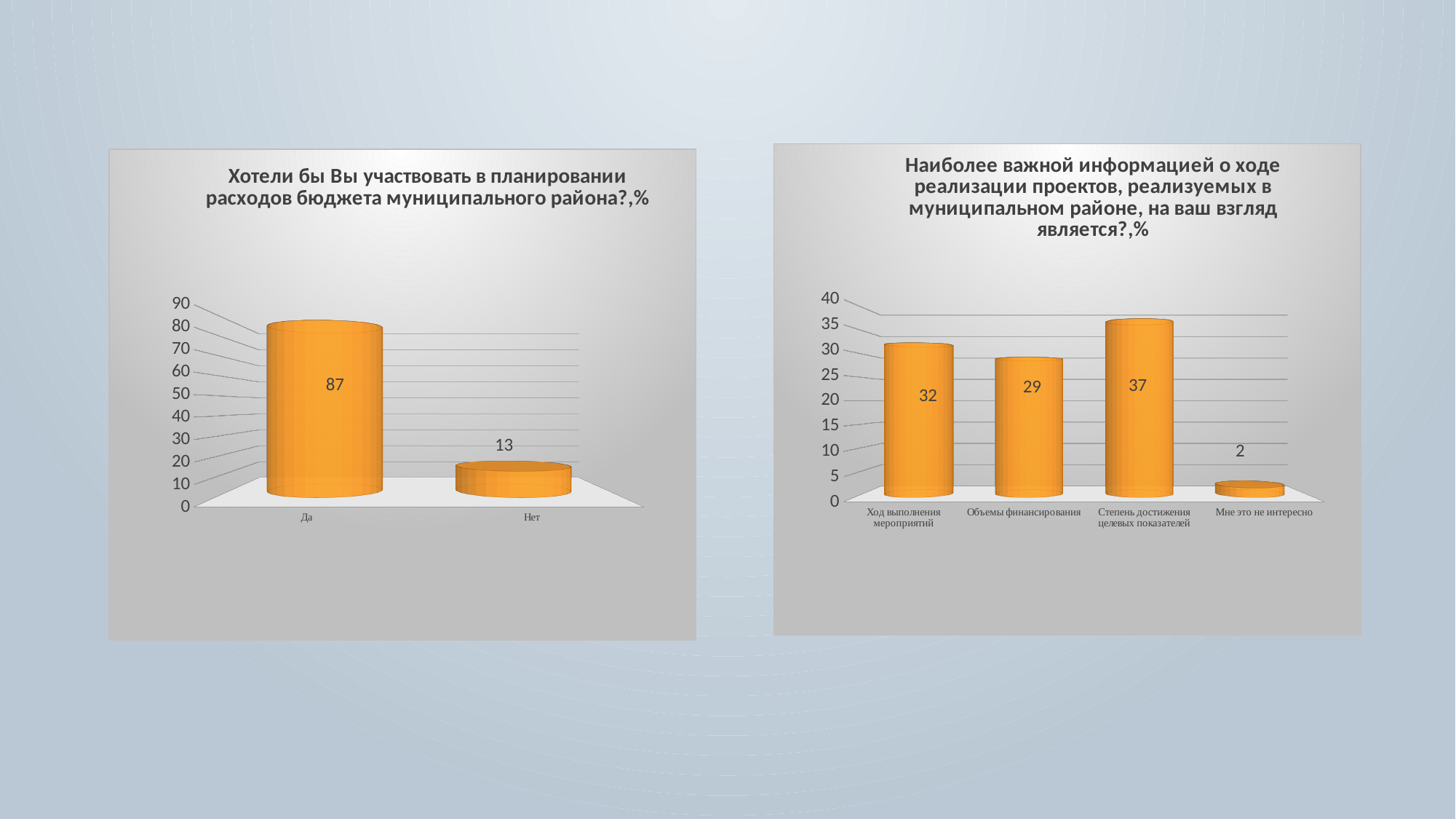
In the left chart, what is the difference between the values for "Да" and "Нет"? 74 In the right chart, which category has the highest value? Степень достижения целевых показателей In the right chart, which category has the lowest value? Мне это не интересно In the left chart, what is the value for "Нет"? 13 In the left chart, how many categories are shown? 2 In the right chart, what is the difference between "Степень достижения целевых показателей" and "Ход выполнения мероприятий"? 5 What kind of chart is the left chart? bar chart In the right chart, which is larger: "Ход выполнения мероприятий" or "Объемы финансирования"? Ход выполнения мероприятий In the right chart, what is the value for "Объемы финансирования"? 29 In the right chart, how many categories are shown? 4 In the right chart, what is the value for "Мне это не интересно"? 2 In the left chart, what is the value for "Да"? 87